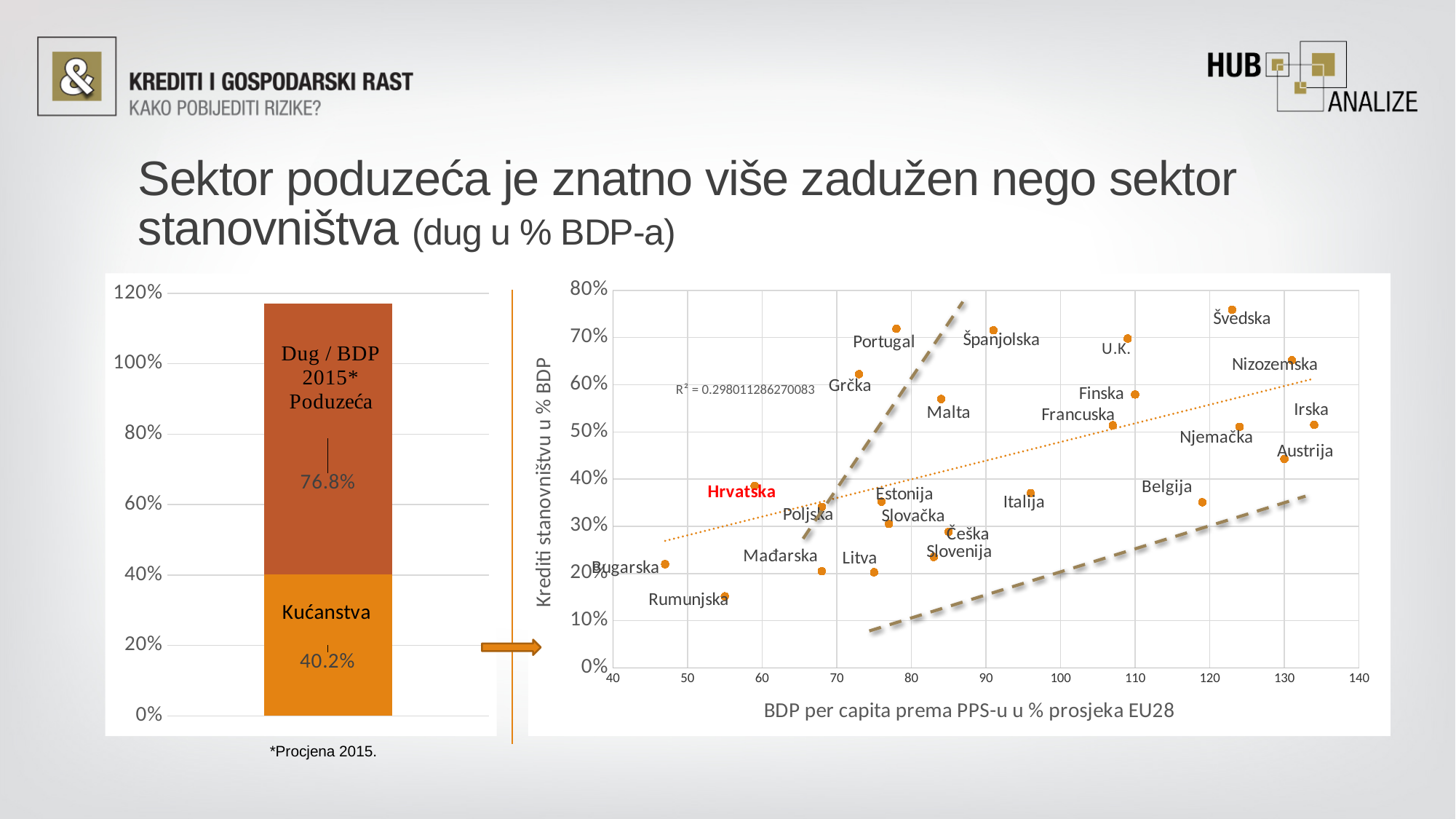
In the left bar chart, what is the difference between the Poduzeća value and the Kućanstva value? 36.6% In the left bar chart, which segment is larger, Poduzeća or Kućanstva? Poduzeća What kind of chart is the chart on the left of the slide? Bar chart In the right scatter chart, is the Krediti stanovništvu u % BDP value for Nizozemska greater or less than 60%? greater In the right scatter chart, is the Krediti stanovništvu u % BDP value for Hrvatska greater or less than 40%? less In the right scatter chart, what is the title of the horizontal axis? BDP per capita prema PPS-u u % prosjeka EU28 What kind of chart is the chart on the right of the slide? Scatter plot In the left bar chart, what is the value shown for Kućanstva? 40.2% In the right scatter chart, which country has the highest value of Krediti stanovništvu u % BDP? Švedska In the right scatter chart, which country has the lowest value of Krediti stanovništvu u % BDP? Rumunjska In the left bar chart, what is the value shown for Poduzeća? 76.8% In the left bar chart, what is the total of the stacked bar (Poduzeća plus Kućanstva)? 117.0%